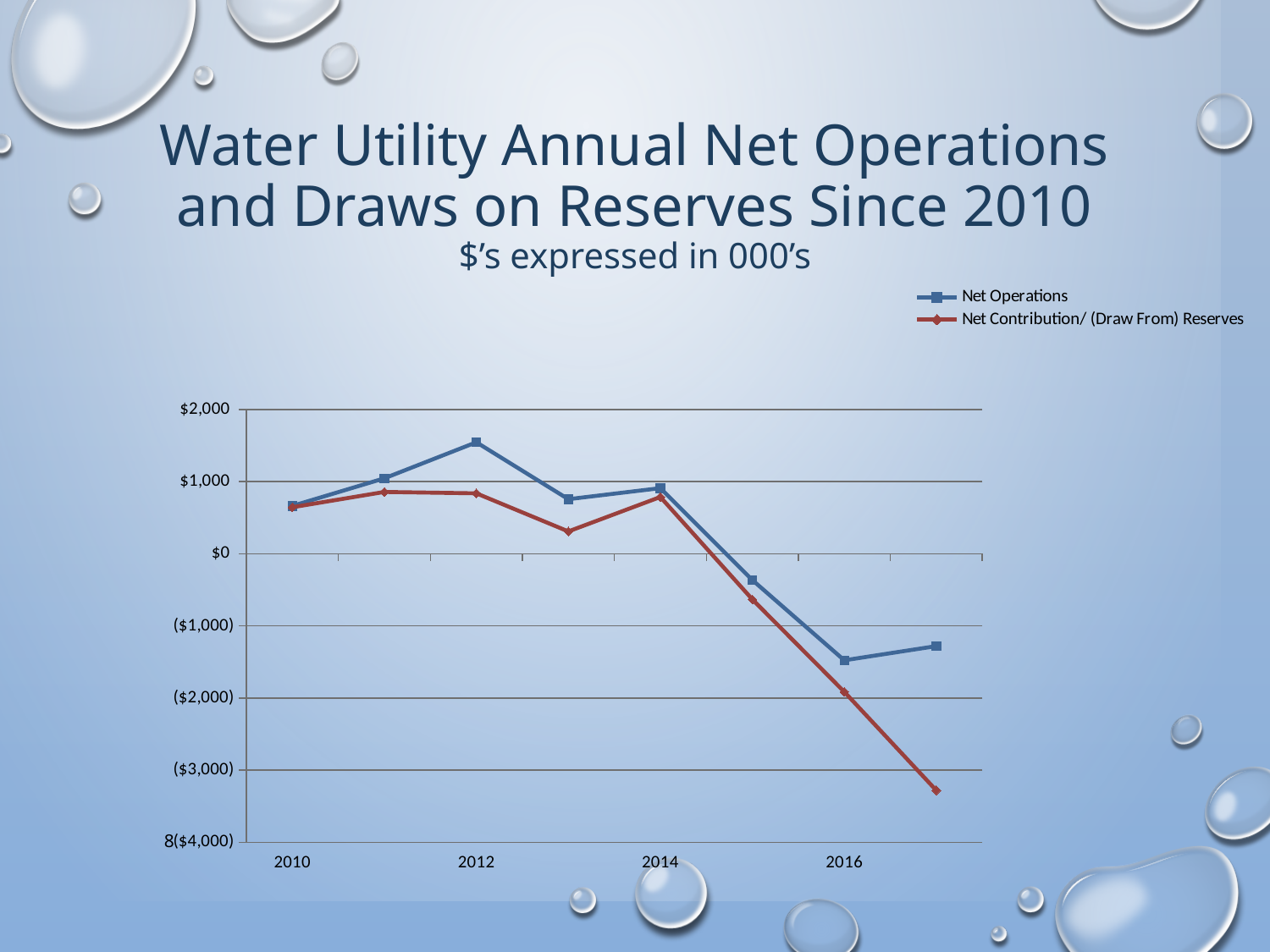
According to the subtitle, in what units are the dollar values expressed? 000's How many data points does the Net Operations line have? 8 In which year does the Net Contribution/ (Draw From) Reserves line reach its lowest value? 2017 Is the Net Contribution/ (Draw From) Reserves value for 2017 greater or less than ($3,000)? less Is the Net Contribution/ (Draw From) Reserves value for 2013 greater or less than $0? greater Does the Net Contribution/ (Draw From) Reserves line rise or fall from 2014 to 2017? fall Is the Net Operations value for 2012 greater or less than $1,000? greater How many series does the legend list? 2 In which year does the Net Operations line reach its highest value? 2012 What kind of chart is shown on the slide? line chart In 2017, which series has the larger value: Net Operations or Net Contribution/ (Draw From) Reserves? Net Operations